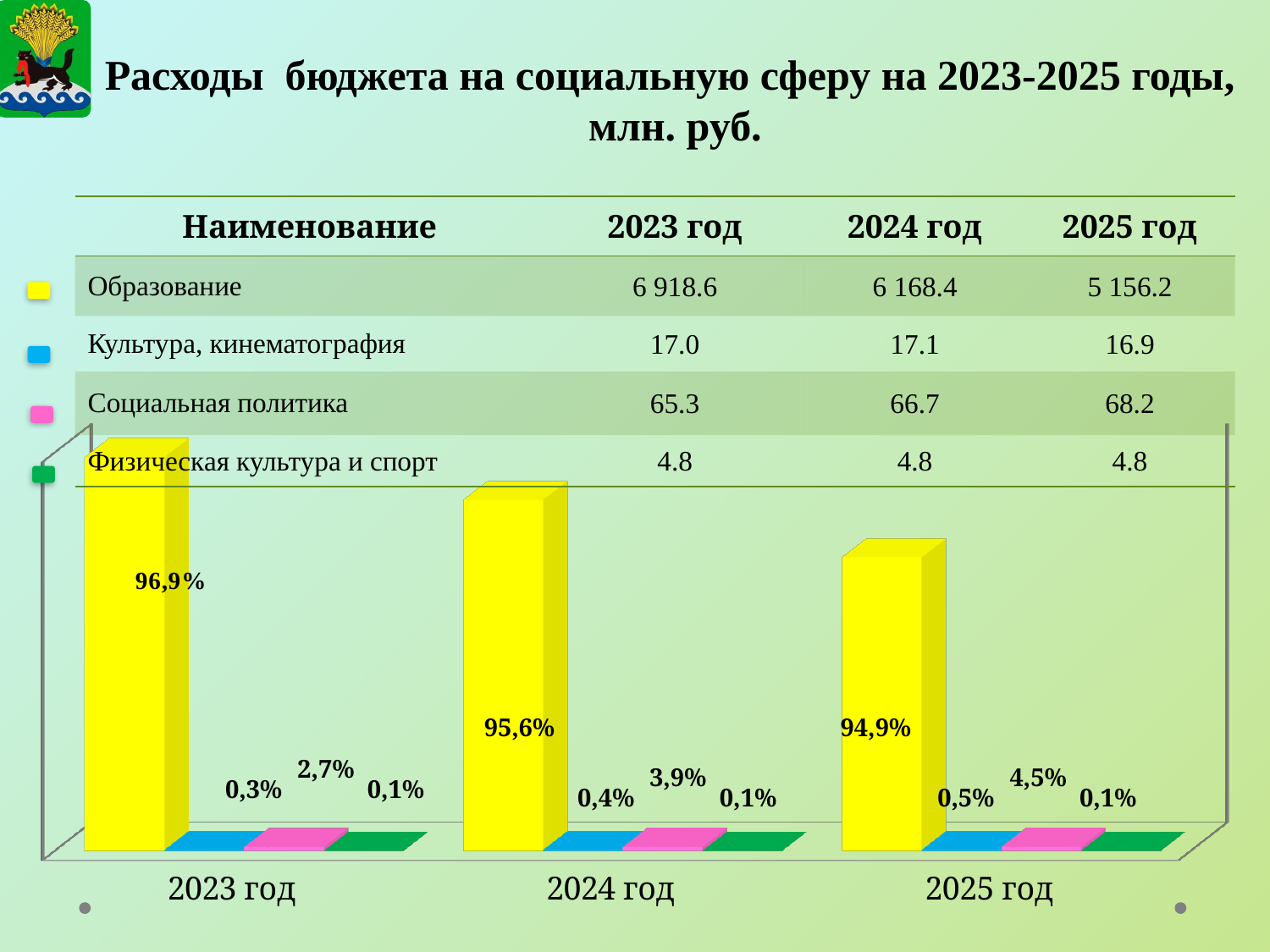
How many year categories are shown on the x axis of the chart? 3 What is the data label on the yellow (Образование) bar for 2023 год? 96,9% What kind of chart is shown on the slide? bar chart Which year has the highest share for the yellow (Образование) bar? 2023 год What is the data label on the yellow (Образование) bar for 2025 год? 94,9% What is the difference between the yellow (Образование) bar labels for 2023 год and 2025 год? 2,0% What is the data label on the blue (Культура, кинематография) bar for 2025 год? 0,5% Does the share for the yellow (Образование) bar rise or fall from 2023 год to 2025 год? fall Which year has the lowest share for the pink (Социальная политика) bar? 2023 год What is the data label on the pink (Социальная политика) bar for 2024 год? 3,9% Which is larger: the pink (Социальная политика) bar for 2025 год or for 2024 год? 2025 год What is the data label on the green (Физическая культура и спорт) bar for 2023 год? 0,1%